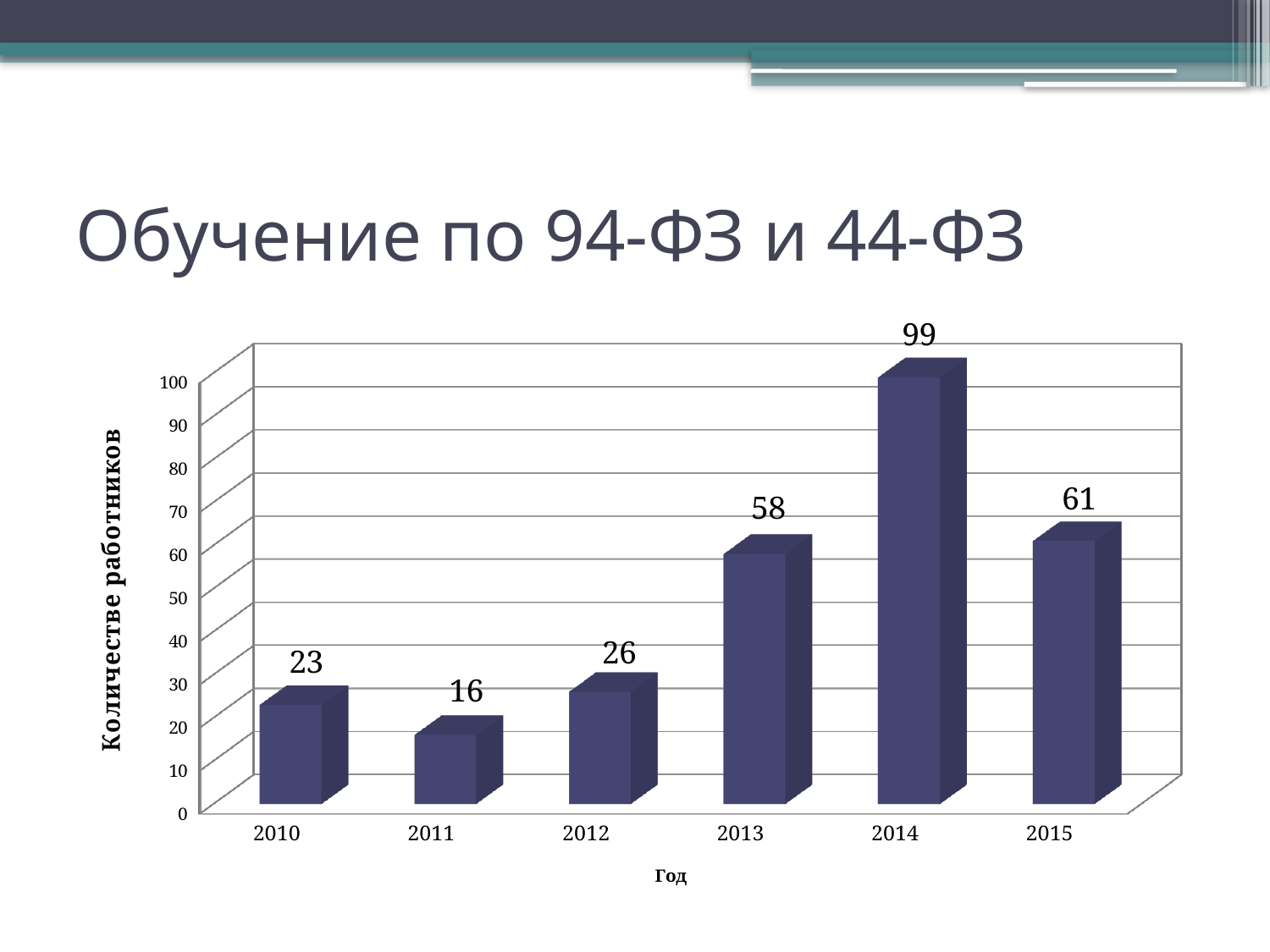
Which year has the lowest value? 2011 Is the value for 2013 greater or less than 50? greater Which is larger, the value for 2013 or the value for 2015? 2015 What is the difference between the values for 2012 and 2010? 3 What is the difference between the values for 2014 and 2015? 38 What is the label of the vertical axis? Количестве работников Which year has the highest value? 2014 What kind of chart is shown on the slide? bar chart What is the value for 2013? 58 What is the value for 2014? 99 How many years are shown on the x axis? 6 What is the value for 2011? 16